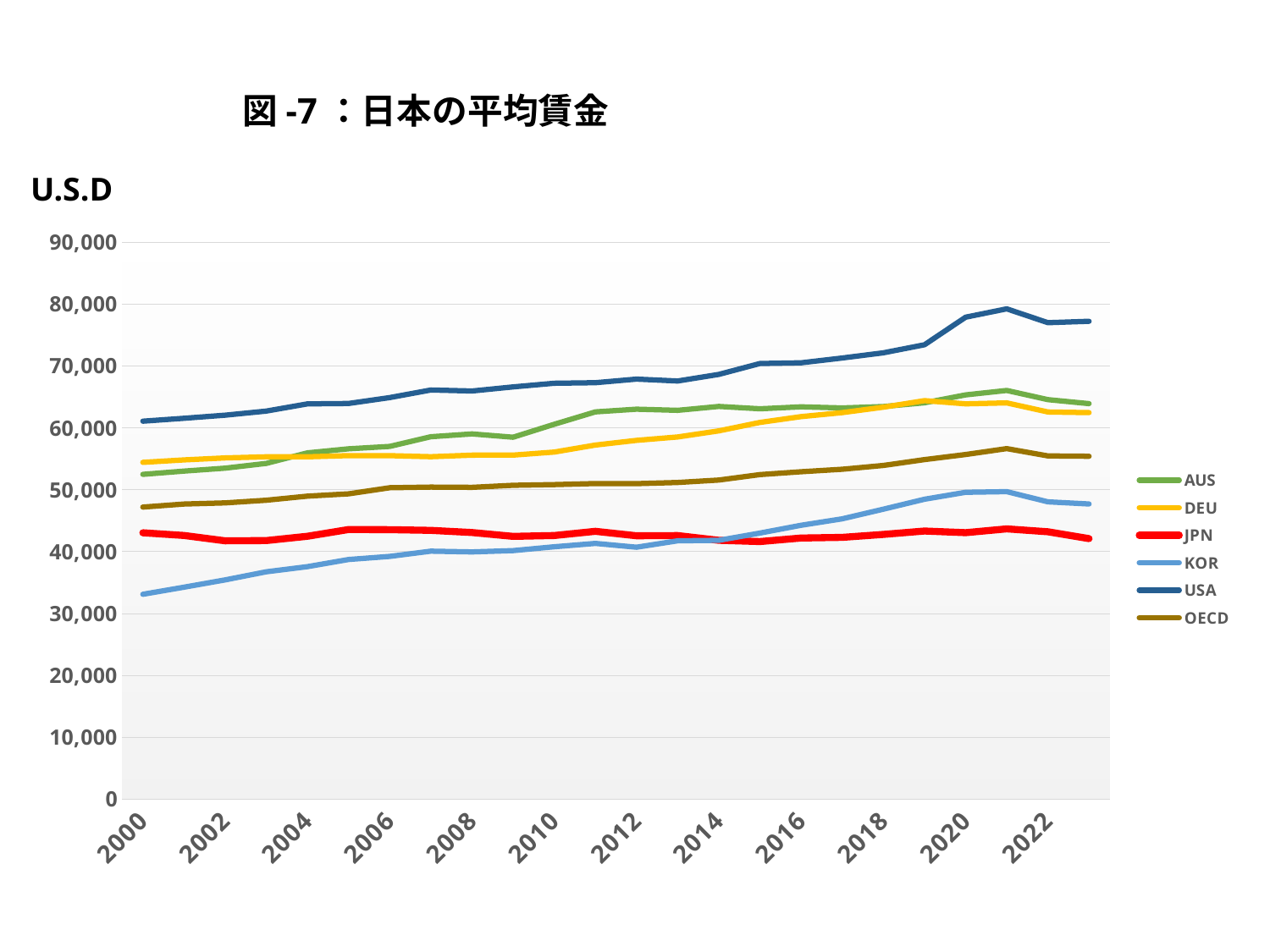
Is the value for KOR in 2000 greater or less than 40,000? less In 2022, which is larger, the value for KOR or the value for JPN? KOR What is the title of the chart? 図 -7 ：日本の平均賃金 Is the value for OECD in 2020 greater or less than 50,000? greater Which series has the highest value in 2022? USA Which series has the lowest value in 2022? JPN Is the value for USA in 2020 greater or less than 70,000? greater What kind of chart is shown on the slide? line chart Which series has the lowest value in 2000? KOR What colour is the JPN line? red Does the KOR line rise or fall from 2000 to 2022? rise How many series does the legend list? 6